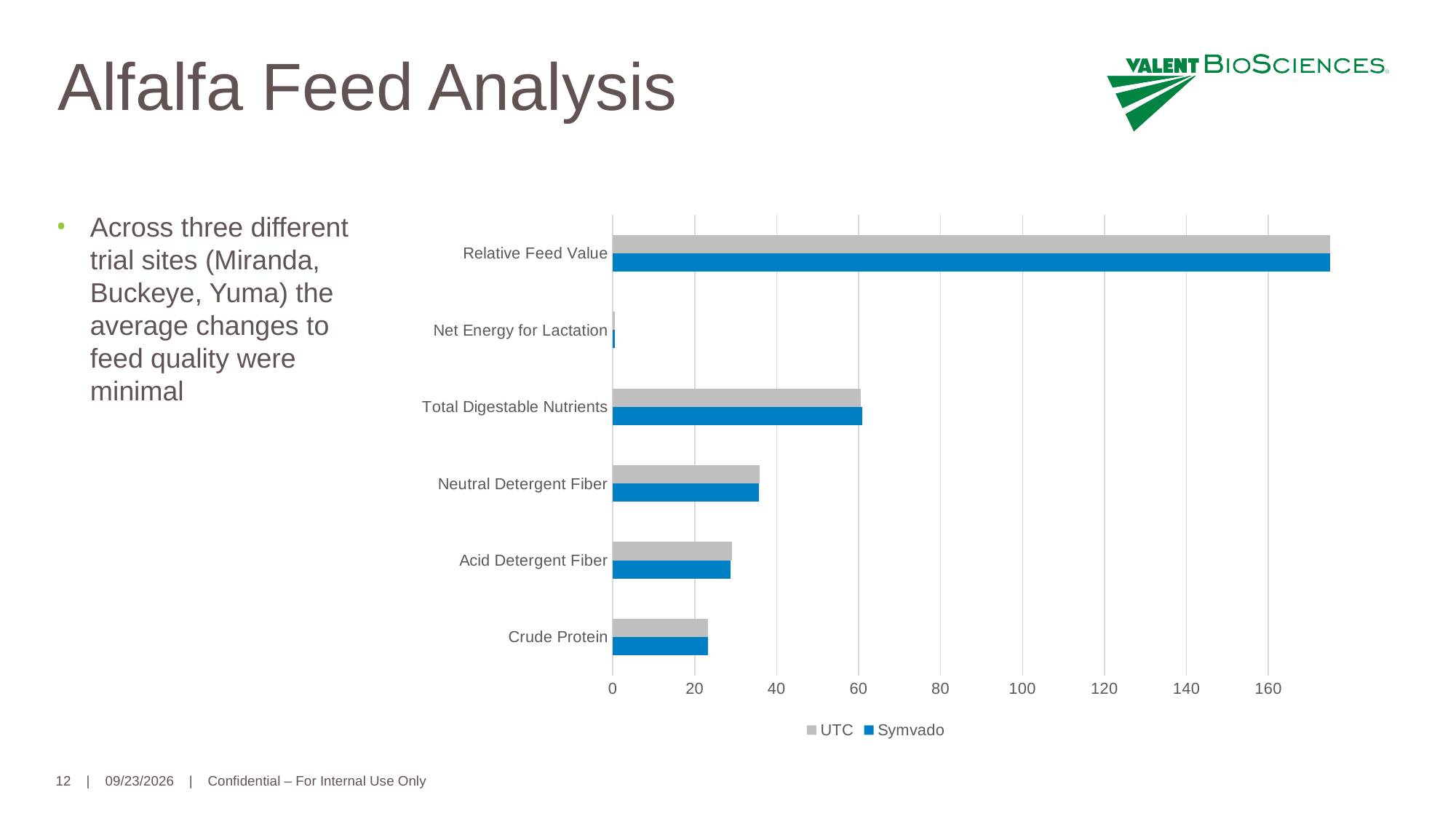
Which category has the highest values on the chart? Relative Feed Value Is the Symvado value for Total Digestable Nutrients greater or less than 40? greater How many categories are plotted on the chart? 6 Is the UTC value for Neutral Detergent Fiber greater or less than 40? less Which is larger, the Symvado value for Total Digestable Nutrients or the Symvado value for Neutral Detergent Fiber? Total Digestable Nutrients Which category has the lowest values on the chart? Net Energy for Lactation How many series does the legend list? 2 Is the Symvado value for Net Energy for Lactation greater or less than 20? less What kind of chart is shown on the slide? Bar chart Which series is shown in blue in the legend? Symvado Which is larger, the UTC value for Acid Detergent Fiber or the UTC value for Crude Protein? Acid Detergent Fiber